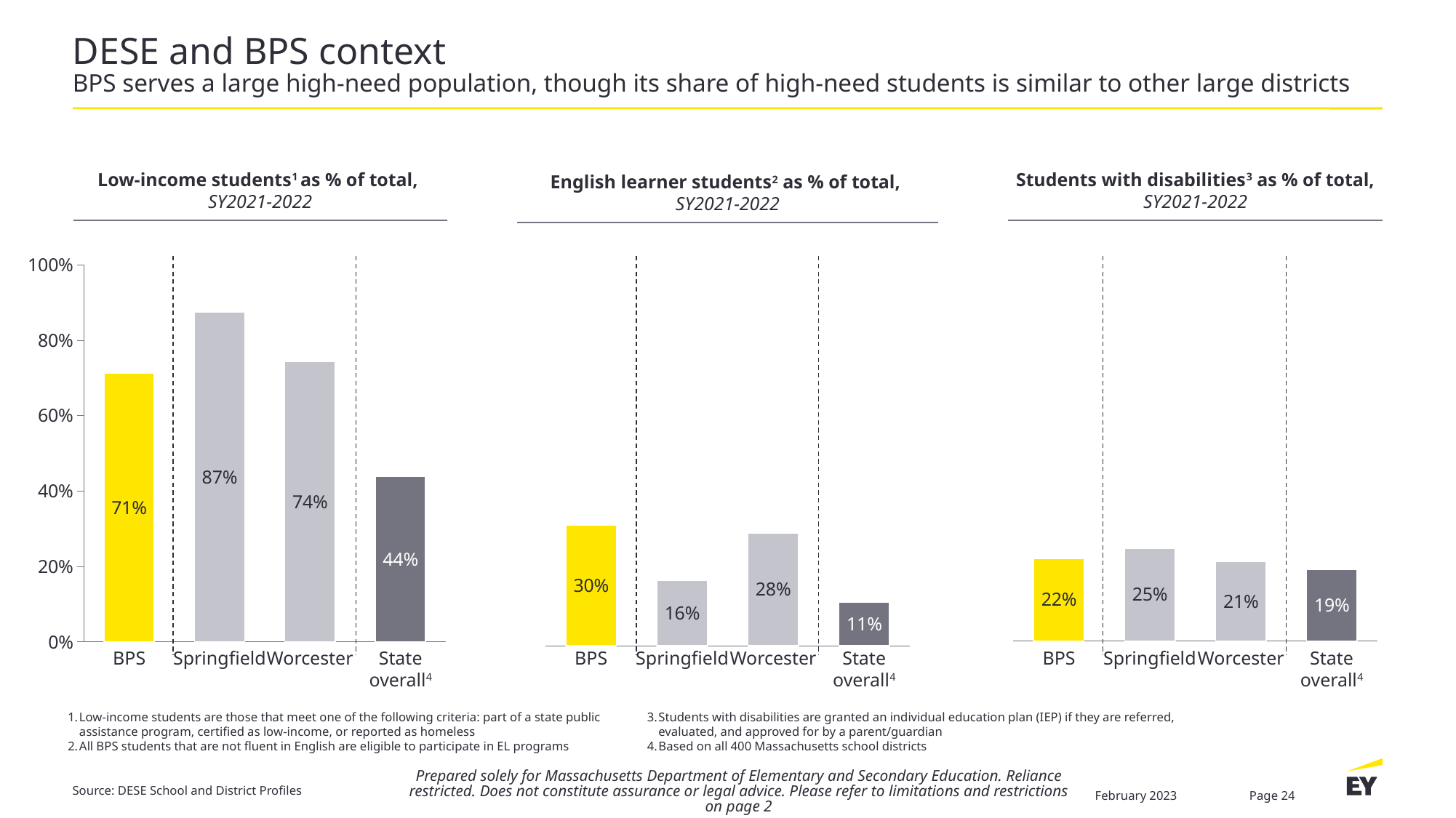
In the 'Students with disabilities as % of total' chart, which category has the highest value? Springfield In the 'Low-income students as % of total' chart, what is the value for BPS? 71% What kind of chart is the 'English learner students as % of total' chart? Bar chart How many categories are shown in the 'Low-income students as % of total' chart? 4 In the 'Students with disabilities as % of total' chart, what is the difference between BPS and Worcester? 1% In the 'Low-income students as % of total' chart, is the value for State overall greater or less than 60%? less In the 'English learner students as % of total' chart, which is larger, BPS or Springfield? BPS In the 'English learner students as % of total' chart, which category has the lowest value? State overall In the 'Low-income students as % of total' chart, which district or category has the highest value? Springfield In the 'Low-income students as % of total' chart, what is the difference between Springfield and BPS? 16% In the 'English learner students as % of total' chart, what is the value for Worcester? 28% In the 'Students with disabilities as % of total' chart, what is the value for State overall? 19%